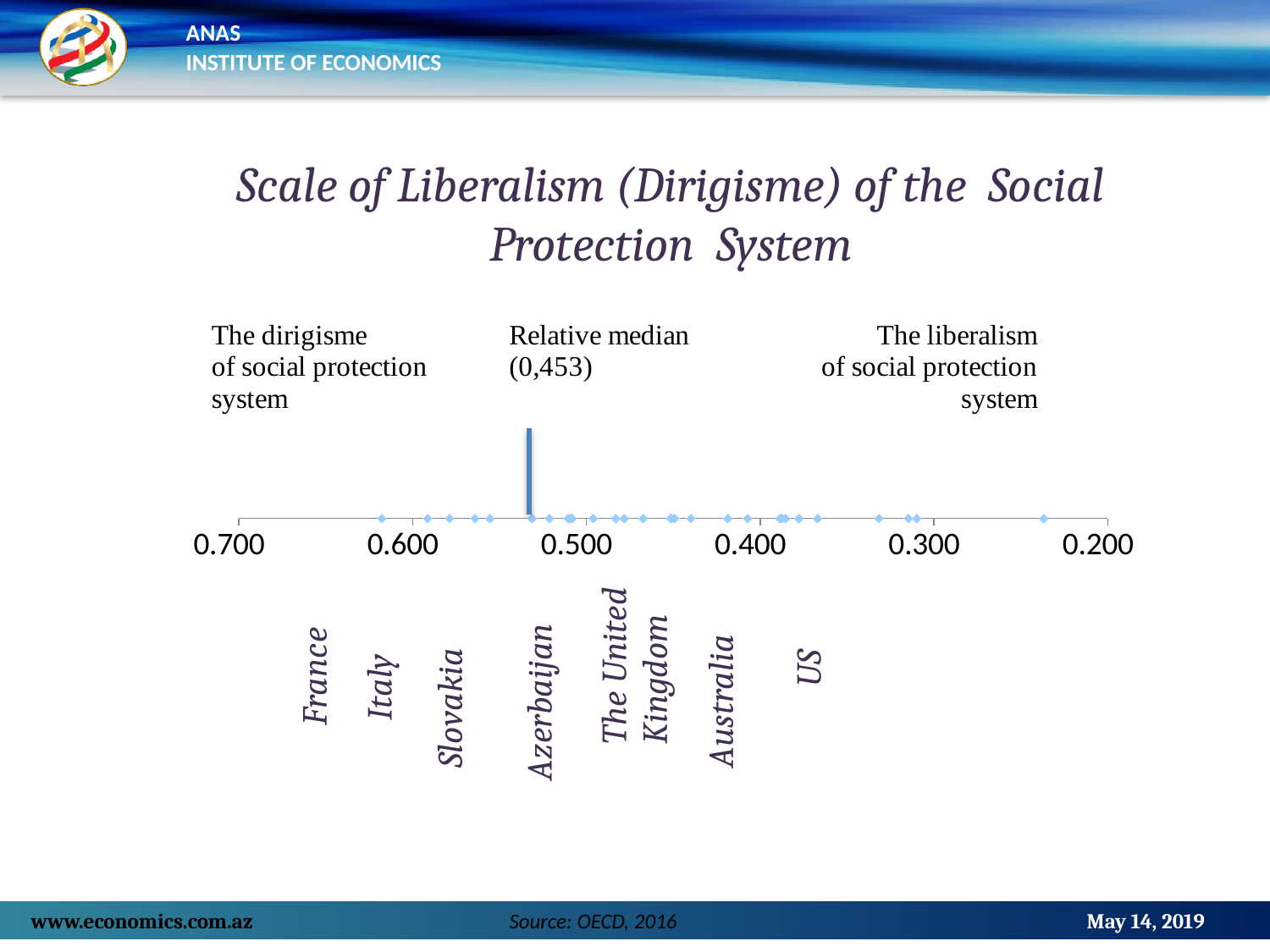
Which is placed further toward the dirigisme end of the scale, France or US? France What is the title of the chart on the slide? Scale of Liberalism (Dirigisme) of the Social Protection System How many countries are labeled below the axis of the chart? 7 Which labeled country is placed closest to the dirigisme end of the scale? France What kind of chart is shown on the slide? Scatter (dot) plot along a single axis What is the rightmost value printed on the chart's axis? 0.200 Is the relative median value greater or less than 0.500? less Which labeled country is placed closest to the liberalism end of the scale? US What is the leftmost value printed on the chart's axis? 0.700 What is the value of the relative median shown on the chart? 0,453 Which end of the scale, left or right, is labeled as the liberalism of social protection system? Right Is the relative median value greater or less than 0.400? greater